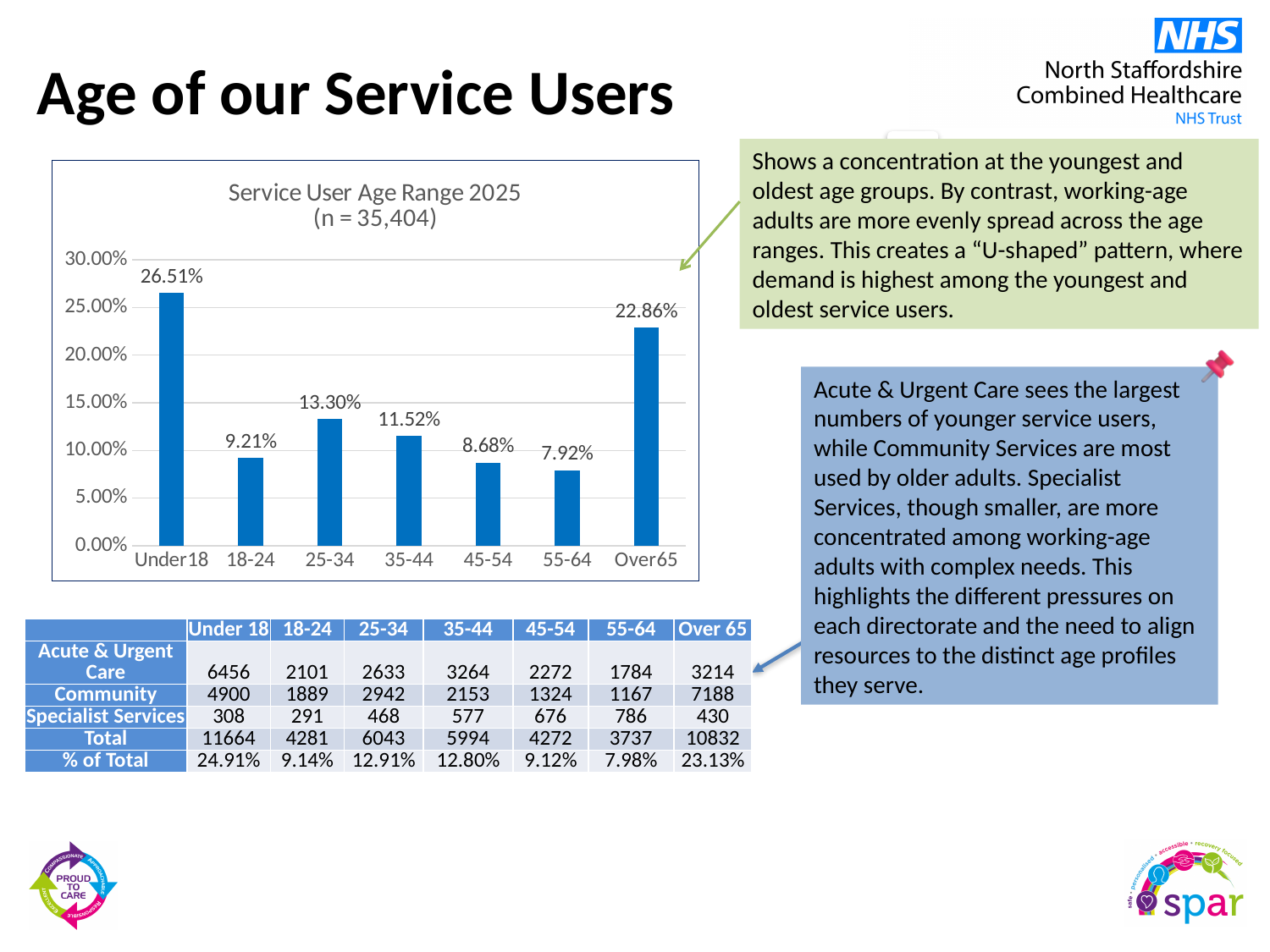
What is the value for Under 18 in the Service User Age Range 2025 chart? 26.51% Do the values in the Service User Age Range 2025 chart rise or fall from 25-34 to 55-64? fall What is the value for 25-34 in the Service User Age Range 2025 chart? 13.30% What is the difference between the values for Under 18 and Over 65 in the Service User Age Range 2025 chart? 3.65% Is the value for 18-24 in the Service User Age Range 2025 chart greater or less than 10.00%? less Which age range has the highest value in the Service User Age Range 2025 chart? Under 18 Which is larger in the Service User Age Range 2025 chart, the value for 35-44 or the value for 45-54? 35-44 What sample size (n) is given in the title of the Service User Age Range 2025 chart? 35,404 What is the value for Over 65 in the Service User Age Range 2025 chart? 22.86% How many age ranges are shown in the Service User Age Range 2025 chart? 7 What kind of chart is the Service User Age Range 2025 chart? bar chart Which age range has the lowest value in the Service User Age Range 2025 chart? 55-64